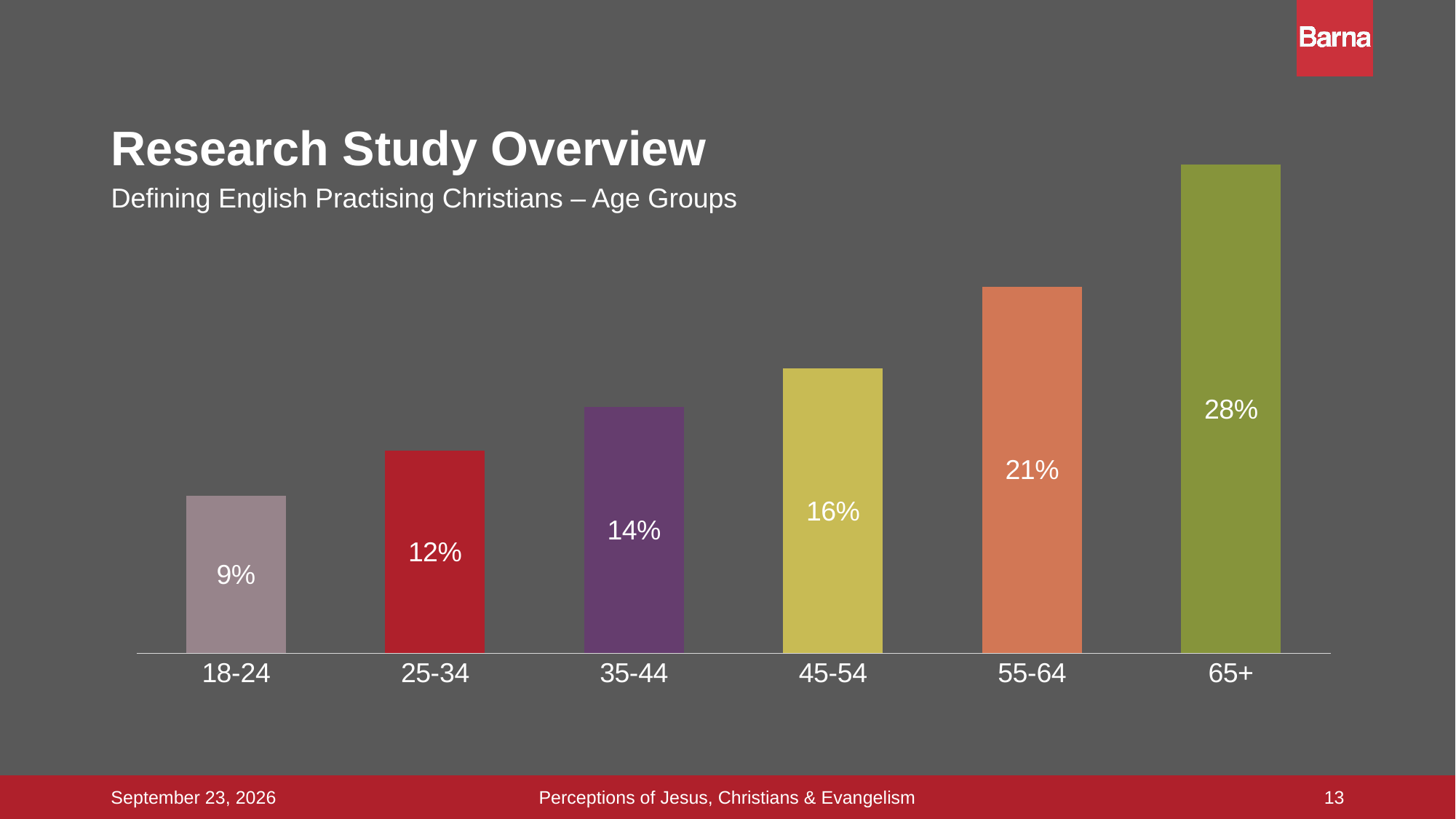
What is the value for the 45-54 age group? 16% What is the difference between the values for 65+ and 18-24? 19% Which age group has the lowest value? 18-24 What is the difference between the values for 35-44 and 25-34? 2% Do the values rise or fall from the 18-24 group to the 65+ group? Rise What kind of chart is shown on the slide? Bar chart What is the value for the 55-64 age group? 21% What is the subtitle of the chart on the slide? Defining English Practising Christians – Age Groups What is the value for the 18-24 age group? 9% Which age group has the highest value? 65+ Which is larger, the value for 25-34 or the value for 45-54? 45-54 How many age groups are shown in the chart? 6